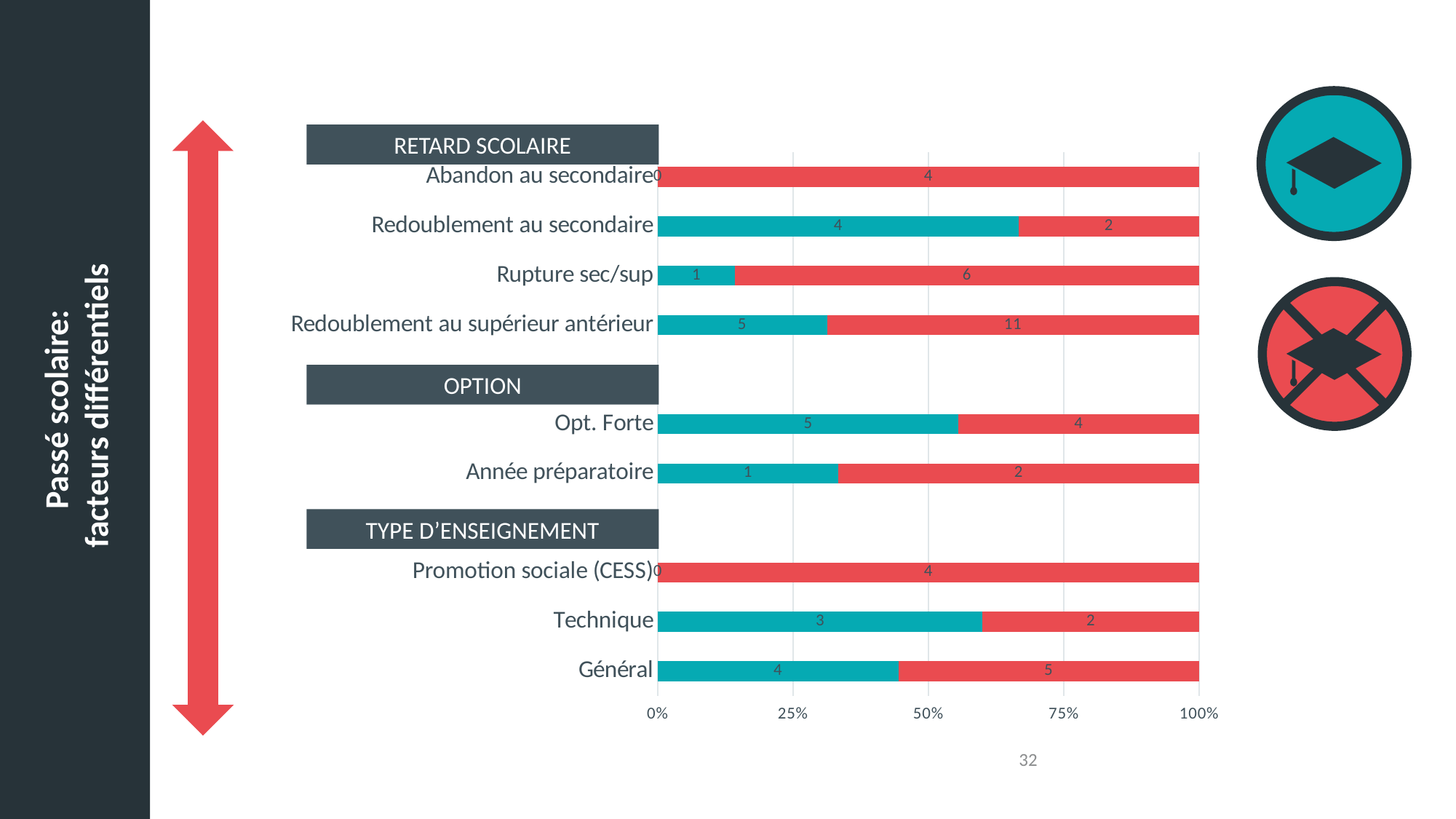
What is the difference between the red and teal segment values for Rupture sec/sup? 5 What kind of chart is shown on the slide? bar chart Is the teal segment for Général greater or less than 50% of the bar? less What is the value of the teal segment for Opt. Forte? 5 What is the value of the red segment for Redoublement au supérieur antérieur? 11 Which category has the larger teal segment value, Technique or Général? Général What is the value of the teal segment for Abandon au secondaire? 0 What is the total of the two segments for Général? 9 Is the teal segment for Redoublement au secondaire greater or less than 50% of the bar? greater What is the total of the two segments for Redoublement au supérieur antérieur? 16 How many categories are plotted in the chart? 9 What is the value of the red segment for Rupture sec/sup? 6